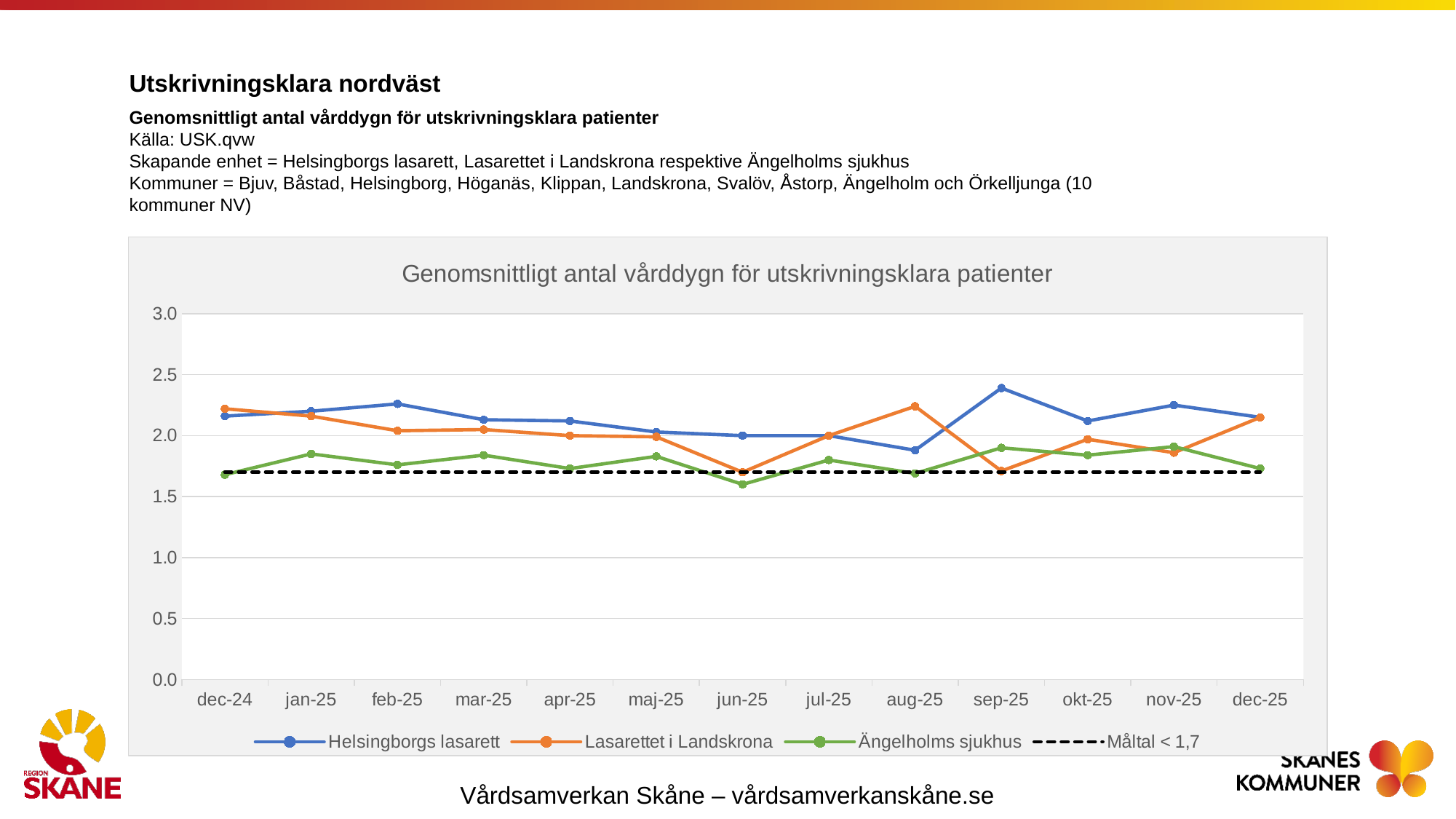
Is the value for Lasarettet i Landskrona in dec-24 greater or less than 2.0? greater Is the value for Helsingborgs lasarett in sep-25 greater or less than 2.0? greater How many entries does the legend list? 4 What is the label of the dashed black line in the legend? Måltal < 1,7 In which month does Helsingborgs lasarett reach its highest value? sep-25 What kind of chart is shown on the slide? Line chart What is the title of the chart? Genomsnittligt antal vårddygn för utskrivningsklara patienter Is the value for Ängelholms sjukhus in jun-25 greater or less than 2.0? less In aug-25, which is higher: Helsingborgs lasarett or Lasarettet i Landskrona? Lasarettet i Landskrona Does the value for Helsingborgs lasarett rise or fall from aug-25 to sep-25? Rise In which month does Ängelholms sjukhus have its lowest value? jun-25 How many months are plotted along the x axis? 13